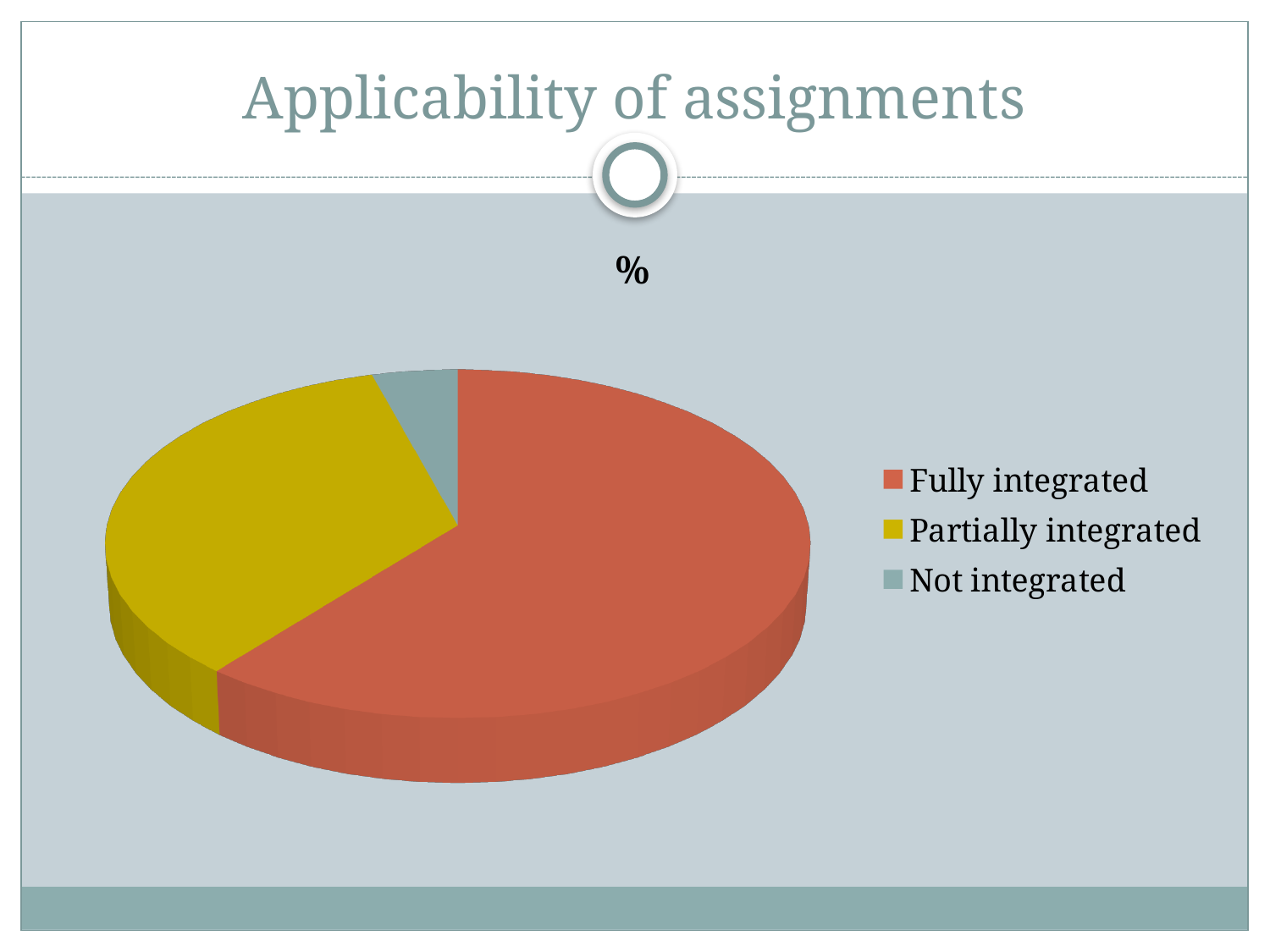
What is the title of the chart? % What kind of chart is shown on the slide? pie chart Which slice is larger, Partially integrated or Not integrated? Partially integrated Which slice is larger, Fully integrated or Partially integrated? Fully integrated Which category has the smallest slice of the pie? Not integrated Which category has the largest slice of the pie? Fully integrated Which category is shown in red? Fully integrated How many entries does the legend list? 3 What colour is the Partially integrated slice? yellow How many slices does the pie chart have? 3